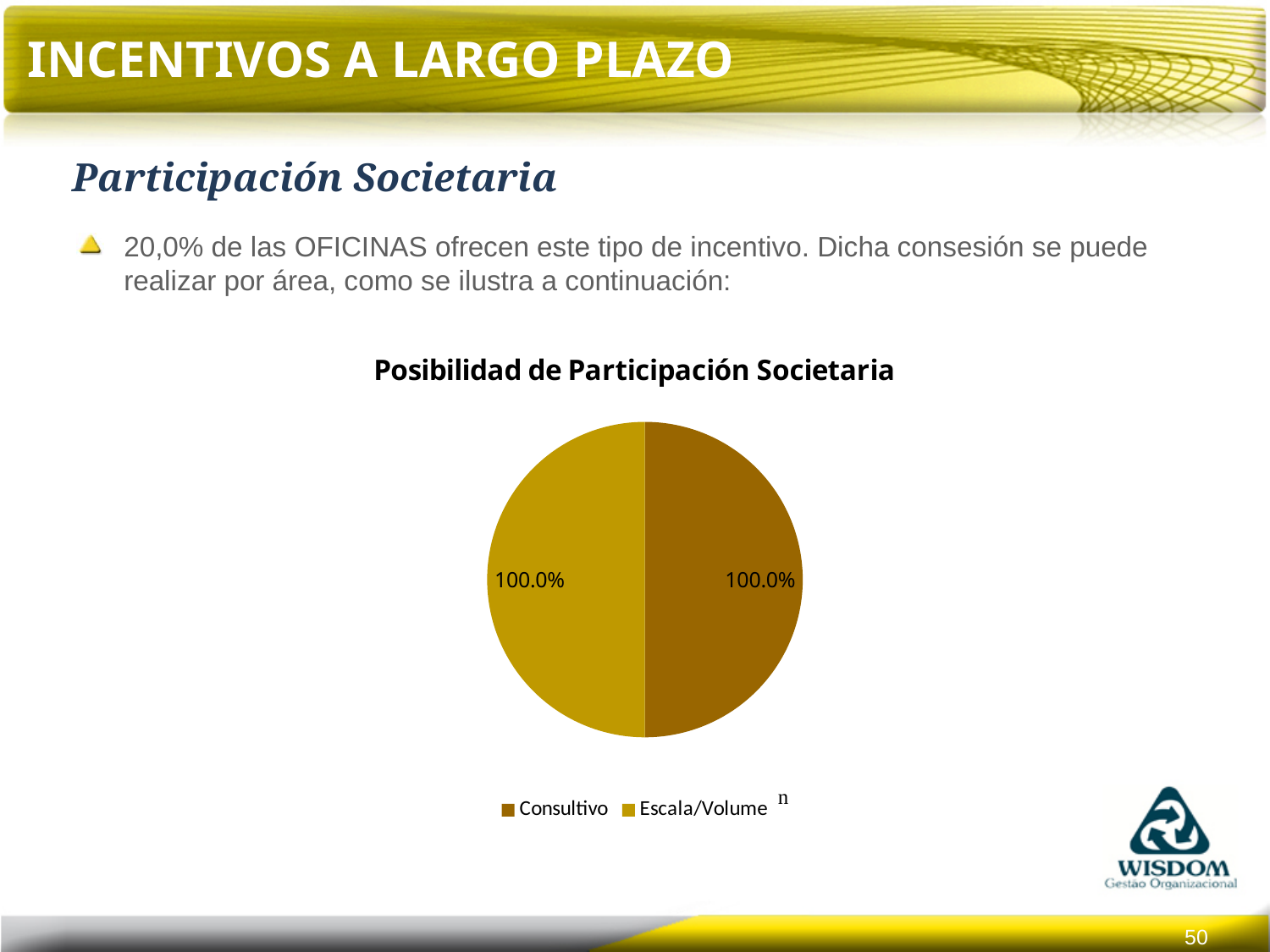
What data label is printed on the Escala/Volume slice of the pie chart? 100.0% How many slices does the pie chart have? 2 What kind of chart is shown on the slide? Pie chart What is the title of the chart on the slide? Posibilidad de Participación Societaria Which slice of the pie chart is on the right-hand side? Consultivo Which slice of the pie chart is on the left-hand side? Escala/Volume Do the Consultivo and Escala/Volume slices show the same data label value? Yes How many entries does the chart legend list? 2 What data label is printed on the Consultivo slice of the pie chart? 100.0% Which legend entry is listed first in the chart legend? Consultivo